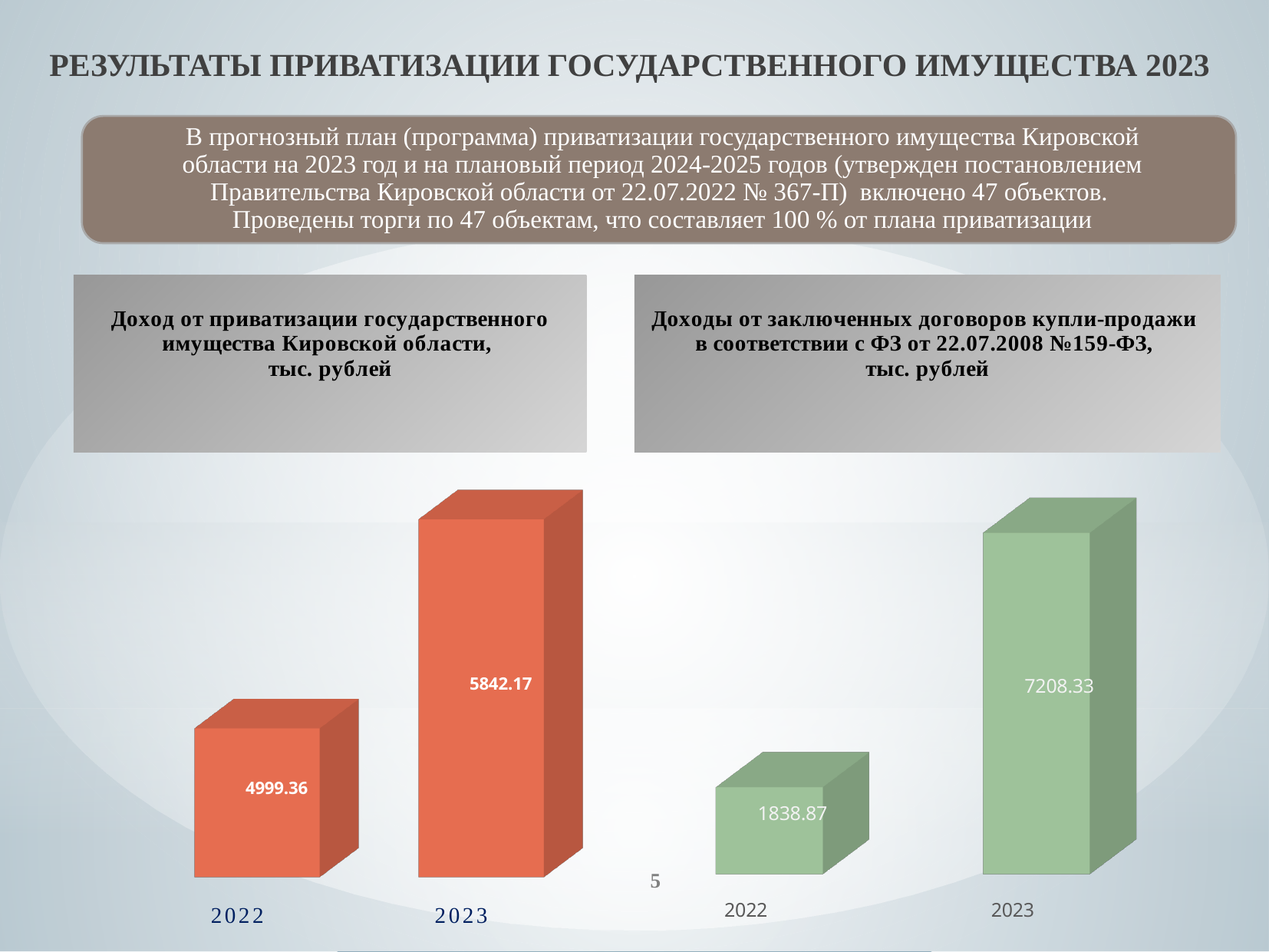
In the right chart, what is the difference between the 2023 and 2022 values? 5369.46 Is the 2023 value in the right chart larger or smaller than the 2023 value in the left chart? larger In the right chart (income from sale-purchase contracts under Federal Law No. 159-FZ), what is the value for 2023? 7208.33 In the right chart, which year has the lower value? 2022 How many bars does the left chart have? 2 In the left chart (income from privatisation of state property of Kirov region), what is the value for 2022? 4999.36 In the left chart, which year has the higher value? 2023 In the right chart (income from sale-purchase contracts under Federal Law No. 159-FZ), what is the value for 2022? 1838.87 In the left chart, what is the difference between the 2023 and 2022 values? 842.81 What type of chart is the right chart? bar chart In the left chart (income from privatisation of state property of Kirov region), what is the value for 2023? 5842.17 In the right chart, do the values rise or fall from 2022 to 2023? rise